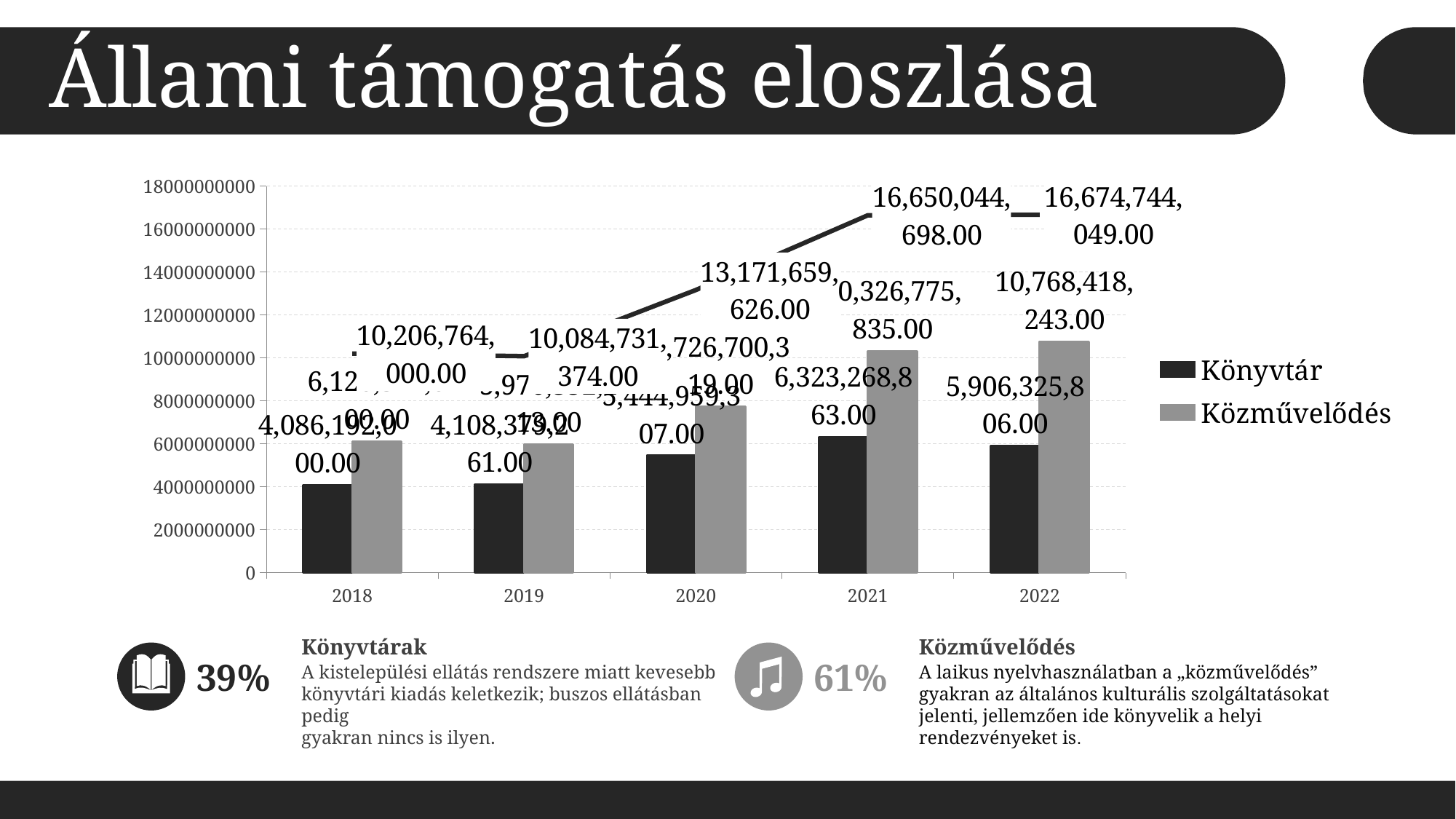
What is the value for Könyvtár in 2021? 6,323,268,863.00 What is the value for Könyvtár in 2018? 4,086,192,000.00 What is the difference between Közművelődés and Könyvtár in 2022? 4,862,092,437.00 In which year is the Közművelődés value highest? 2022 In which year is the Könyvtár value highest? 2021 What is the value for Közművelődés in 2022? 10,768,418,243.00 In 2022, which is larger: Könyvtár or Közművelődés? Közművelődés How many series does the legend list? 2 How many years are shown on the x axis? 5 What is the value for Könyvtár in 2022? 5,906,325,806.00 Is the value for Közművelődés in 2020 greater or less than 6000000000? greater What is the title of the slide containing the chart? Állami támogatás eloszlása